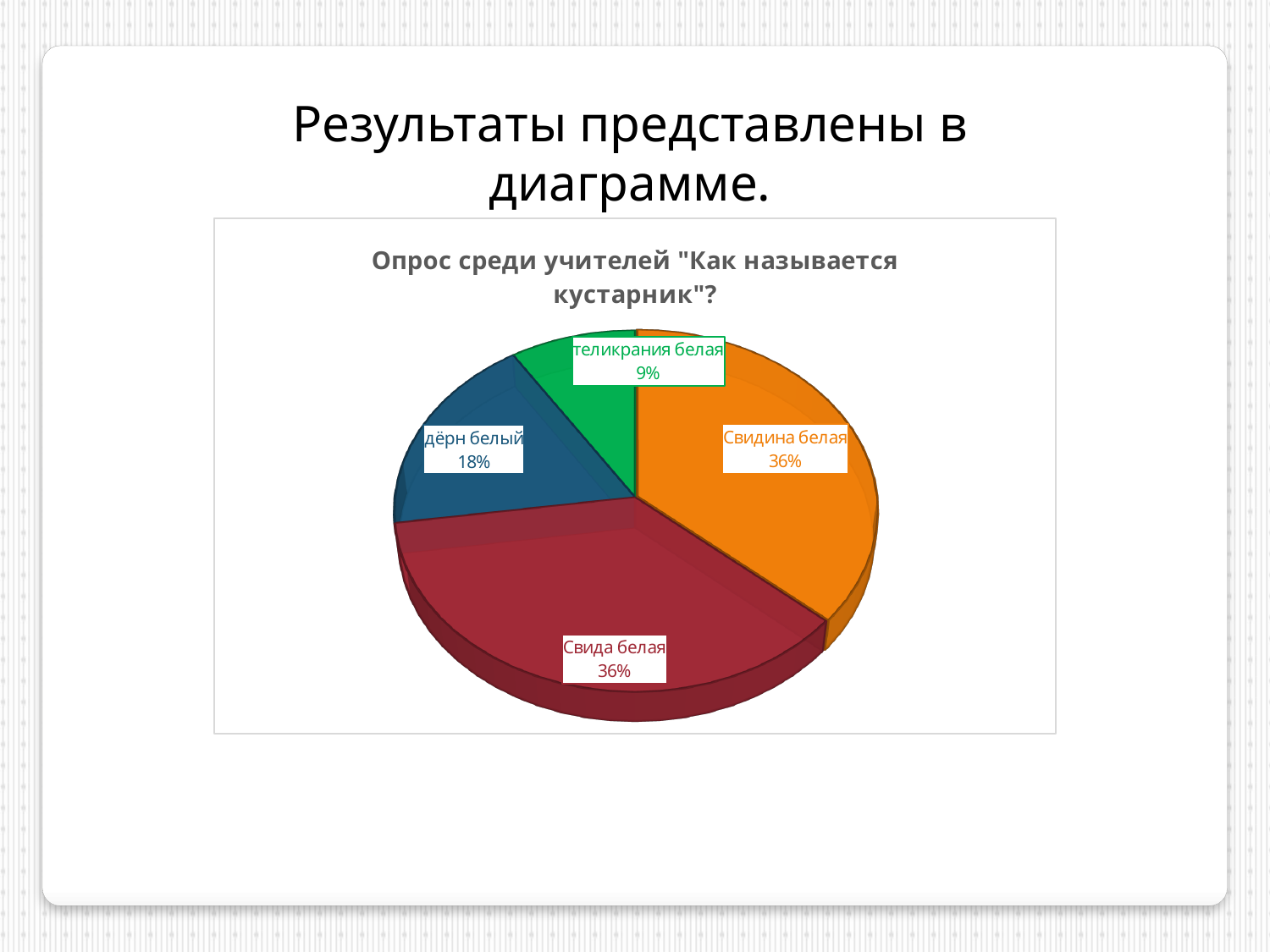
How many slices does the pie chart have? 4 What share of the pie is labelled "Свида белая"? 36% What share of the pie is labelled "Свидина белая"? 36% What share of the pie is labelled "теликрания белая"? 9% What kind of chart is shown on the slide? pie chart Which slice of the pie is the smallest? теликрания белая What is the title of the chart? Опрос среди учителей "Как называется кустарник"? By how many percentage points does the "дёрн белый" slice exceed the "теликрания белая" slice? 9 Which is larger: the slice for "дёрн белый" or the slice for "теликрания белая"? дёрн белый What colour is the slice labelled "Свида белая"? red By how many percentage points does the "Свидина белая" slice exceed the "дёрн белый" slice? 18